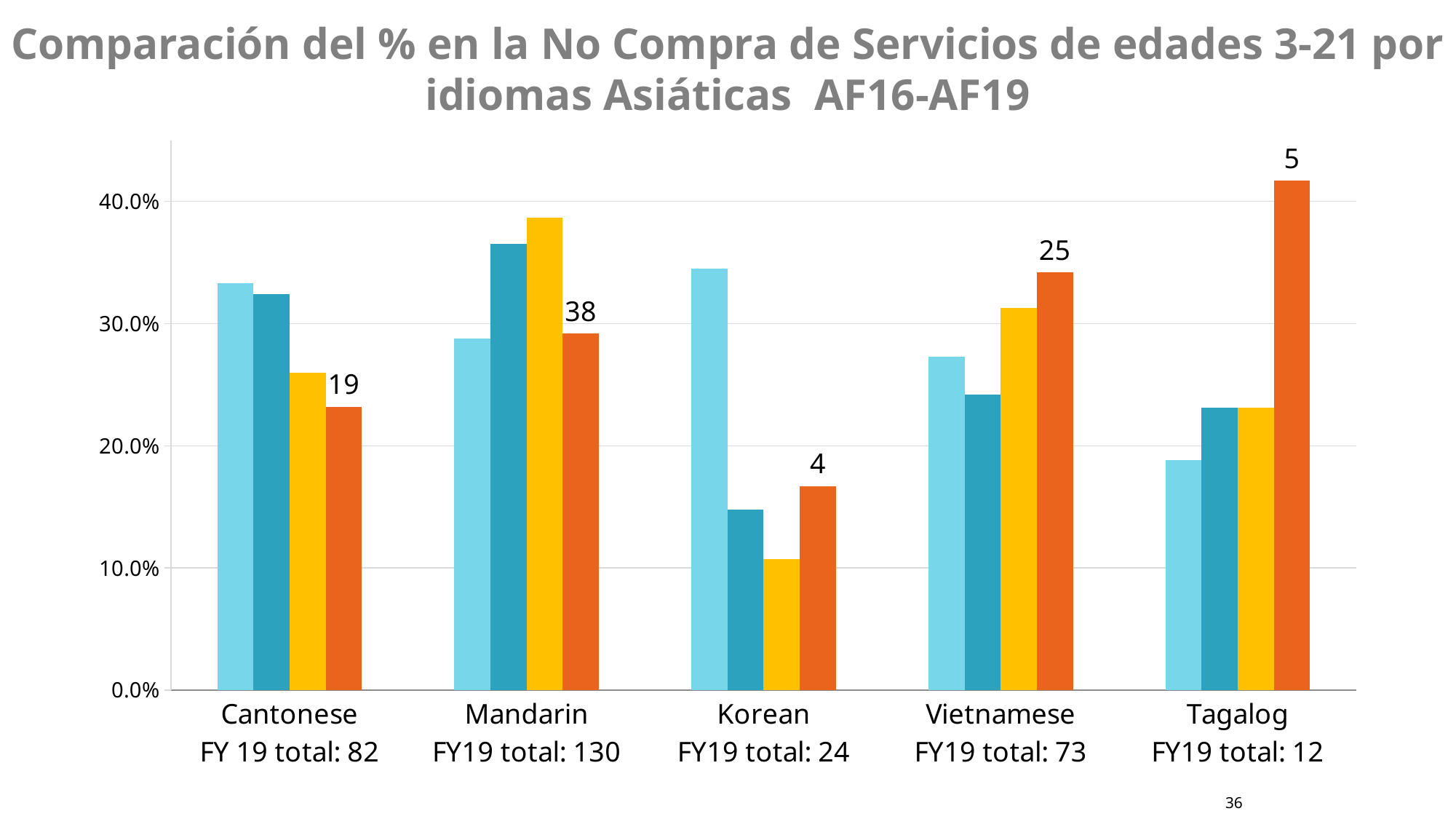
How many language categories are shown on the x axis? 5 For Korean, which is taller: the light blue bar or the dark teal bar? the light blue bar Is the value of the yellow bar for Korean greater or less than 20.0%? less What number is printed above the orange bar for Cantonese? 19 Which language category has the shortest orange bar? Korean What kind of chart is shown on the slide? bar chart Which language category has the tallest orange bar? Tagalog What FY19 total is given in the axis label for Vietnamese? 73 What number is printed above the orange bar for Korean? 4 Is the value of the light blue bar for Cantonese greater or less than 30.0%? greater Is the value of the orange bar for Tagalog greater or less than 40.0%? greater What number is printed above the orange bar for Mandarin? 38